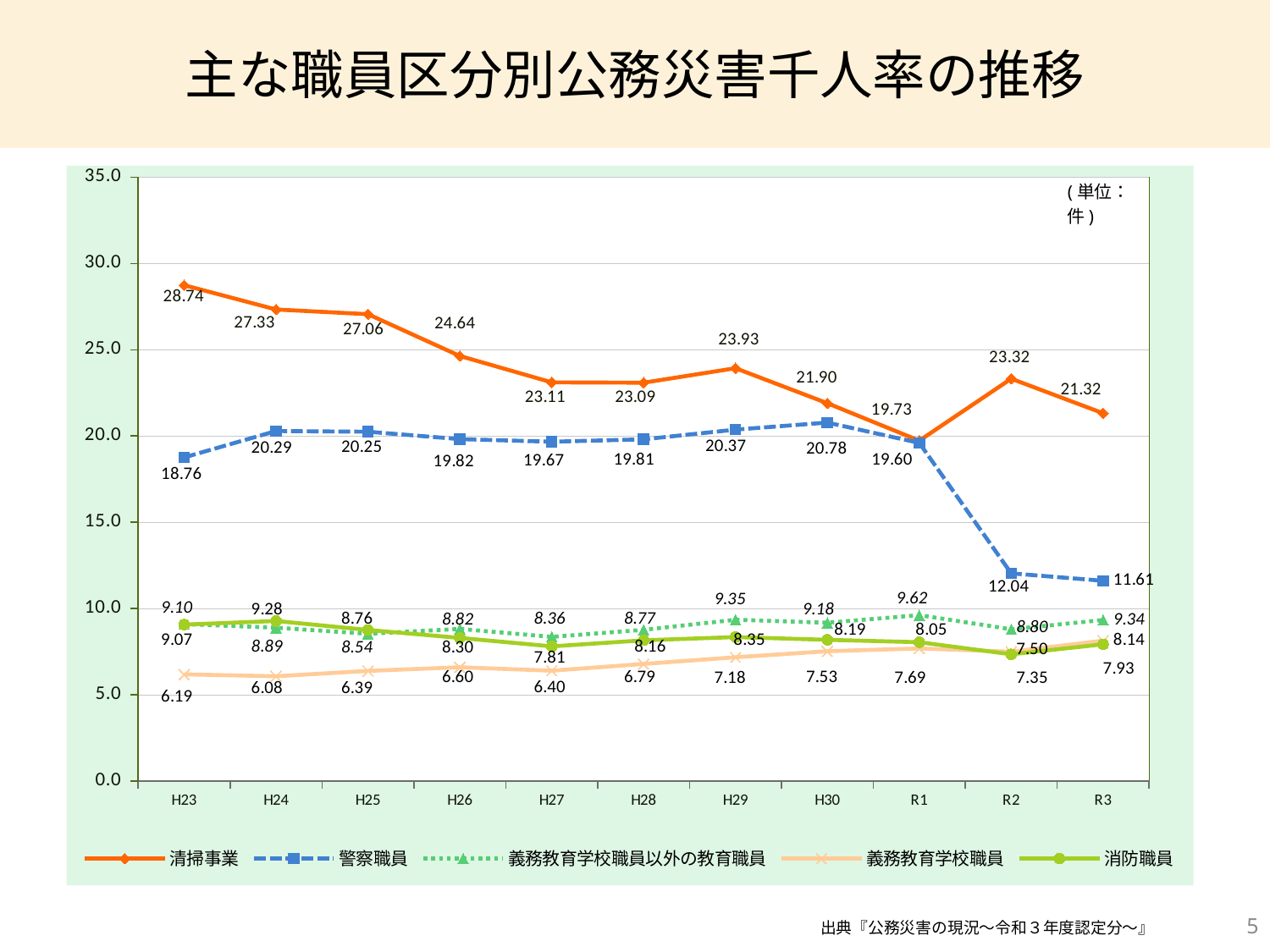
Is the value for 警察職員 in R2 greater or less than 15.0? less How many years are shown on the x axis? 11 What is the difference between the 警察職員 values in R1 and R2? 7.56 In which year is the value for 清掃事業 the lowest? R1 What type of chart is shown on the slide? line chart In which year is the value for 警察職員 the highest? H30 What is the value for 警察職員 in R3? 11.61 How many series does the legend list? 5 Does the value for 義務教育学校職員 generally rise or fall from H23 to R3? rise What is the value for 義務教育学校職員 in H27? 6.40 What is the value for 清掃事業 in H23? 28.74 Which is larger in H23, the value for 清掃事業 or the value for 警察職員? 清掃事業